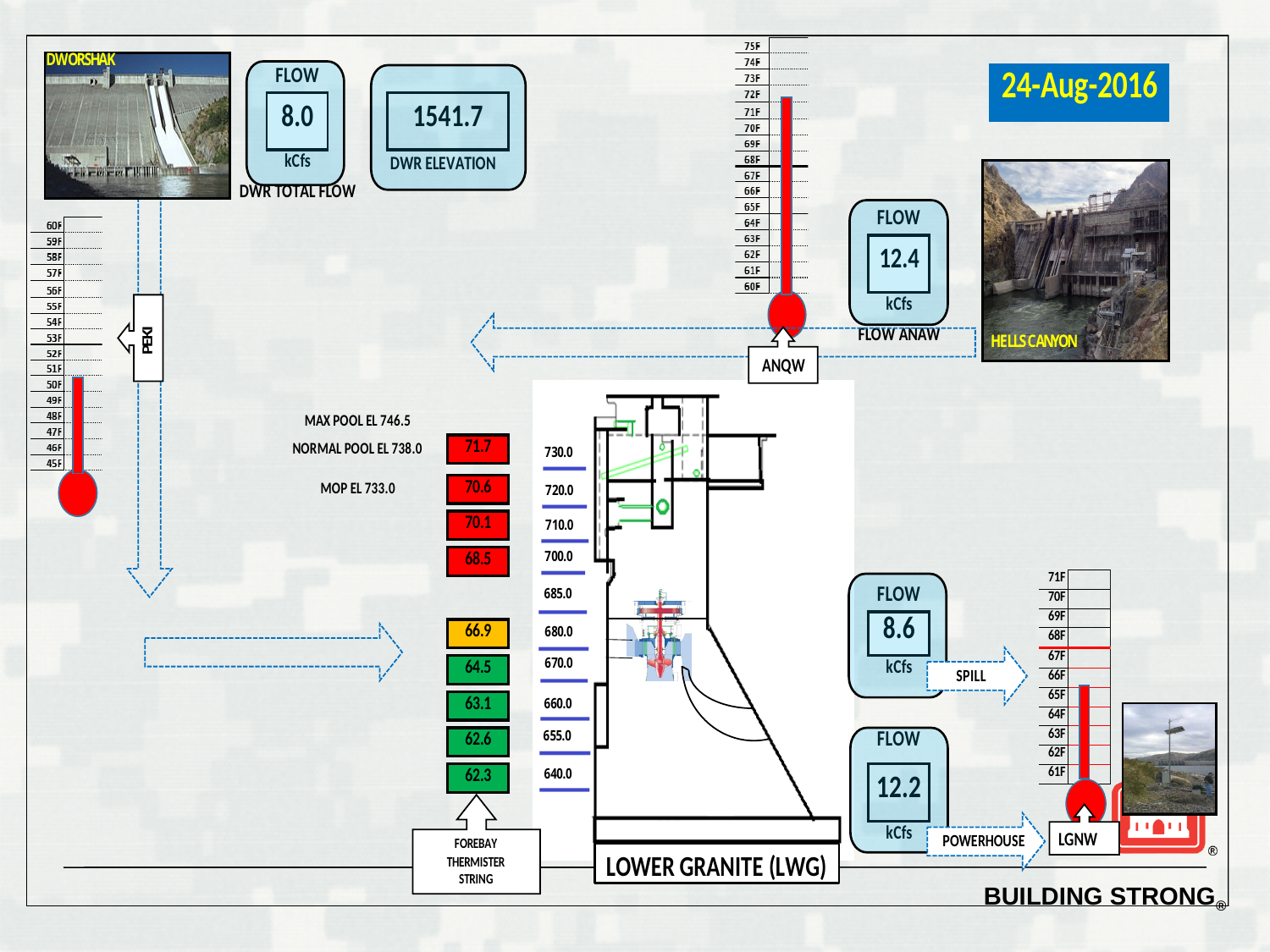
What is the DWR TOTAL FLOW value shown for Dworshak? 8.0 kCfs On the ANQW thermometer, is the temperature greater or less than 70F? greater What is the SPILL flow value shown for Lower Granite (LWG)? 8.6 kCfs In the Forebay Thermister String, what is the highest temperature reading shown? 71.7 How many temperature readings are shown in the Forebay Thermister String? 9 What is the difference between the highest and lowest readings in the Forebay Thermister String? 9.4 What is the FLOW ANAW value shown next to Hells Canyon? 12.4 kCfs What is the DWR ELEVATION value shown on the slide? 1541.7 What is the POWERHOUSE flow value shown for Lower Granite (LWG)? 12.2 kCfs On the LGNW thermometer, is the temperature greater or less than 70F? less Which is larger for Lower Granite, the SPILL flow or the POWERHOUSE flow? POWERHOUSE flow In the Forebay Thermister String, what is the lowest temperature reading shown? 62.3